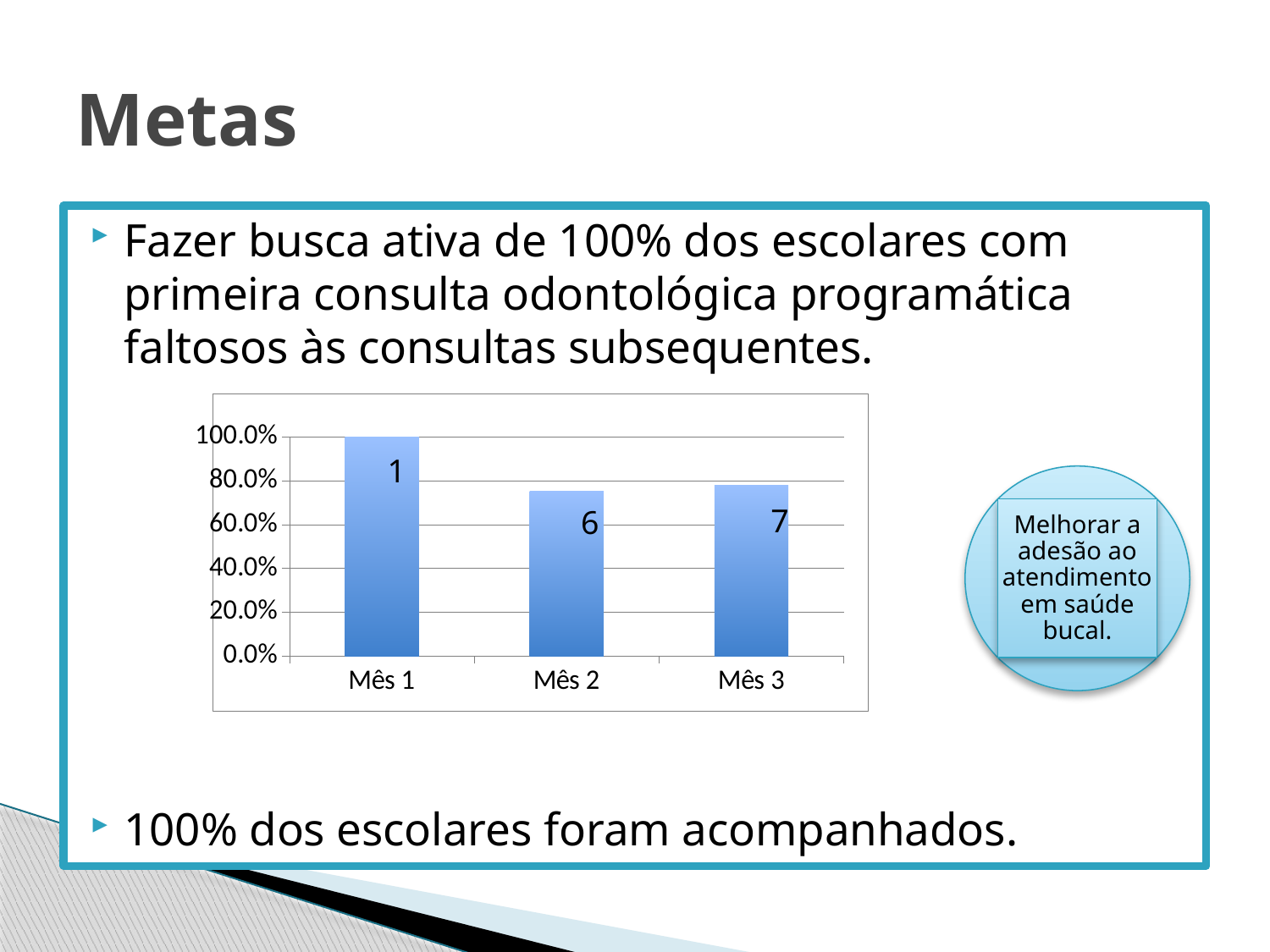
Does the bar height rise or fall from Mês 1 to Mês 2? fall How many categories are shown on the x axis of the chart? 3 Is the value for Mês 2 greater or less than 60.0%? greater What data label is printed on the bar for Mês 1? 1 What data label is printed on the bar for Mês 2? 6 What data label is printed on the bar for Mês 3? 7 What value does the bar for Mês 1 reach on the y axis? 100.0% What is the highest tick label shown on the y axis of the chart? 100.0% Is the value for Mês 2 greater or less than 80.0%? less What kind of chart is shown on the slide? bar chart Which category has the highest bar in the chart? Mês 1